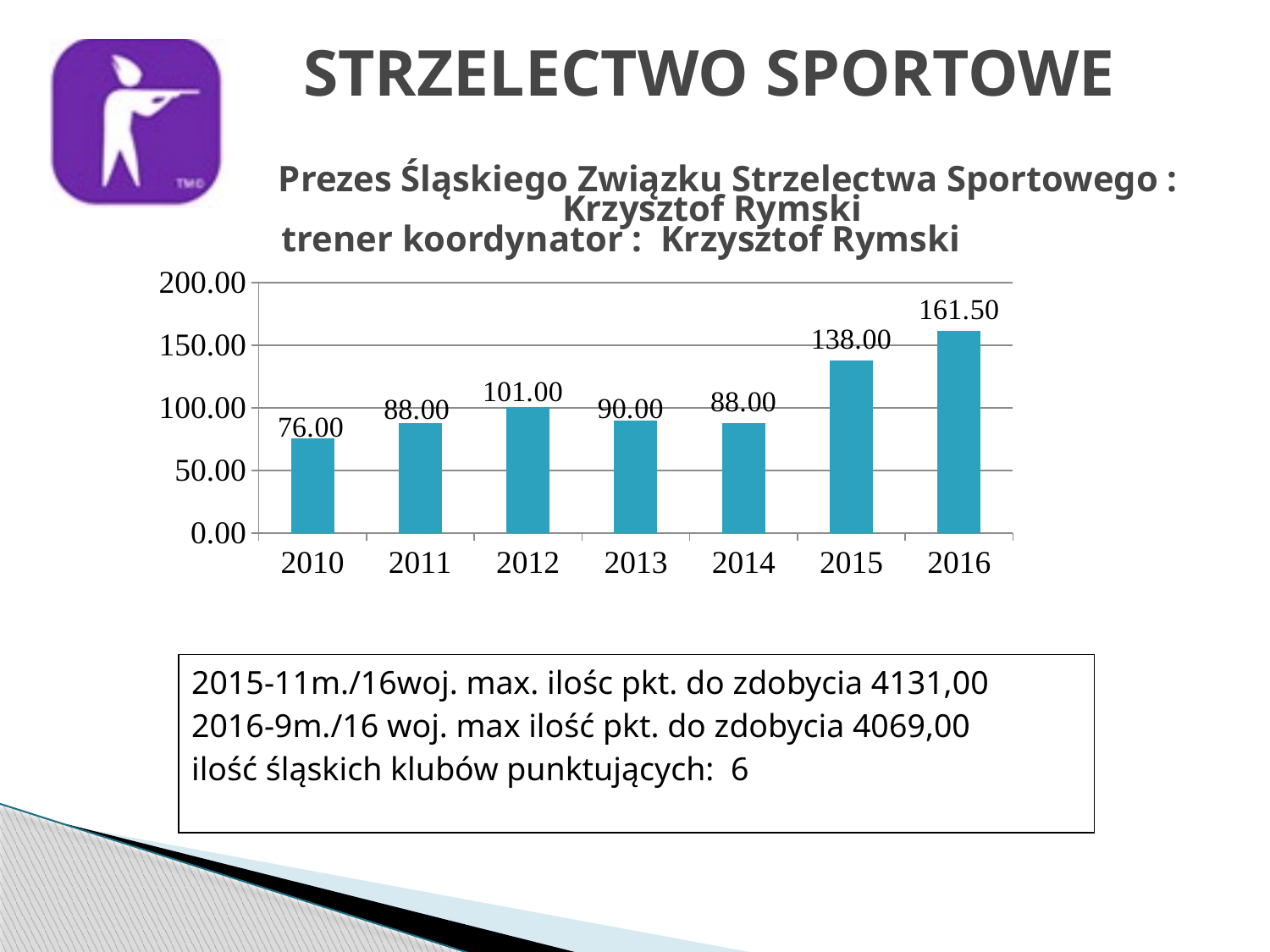
What kind of chart is shown on the slide? bar chart Which year has the lowest value? 2010 What is the value for 2012? 101.00 What is the value for 2010? 76.00 Is the value for 2015 greater or less than 100.00? greater Do the values rise or fall from 2014 to 2016? rise How many years are shown on the x axis? 7 What is the value for 2016? 161.50 What is the difference between the values for 2012 and 2010? 25.00 Which year has the highest value? 2016 Which is larger, the value for 2013 or the value for 2014? 2013 What is the difference between the values for 2016 and 2015? 23.50